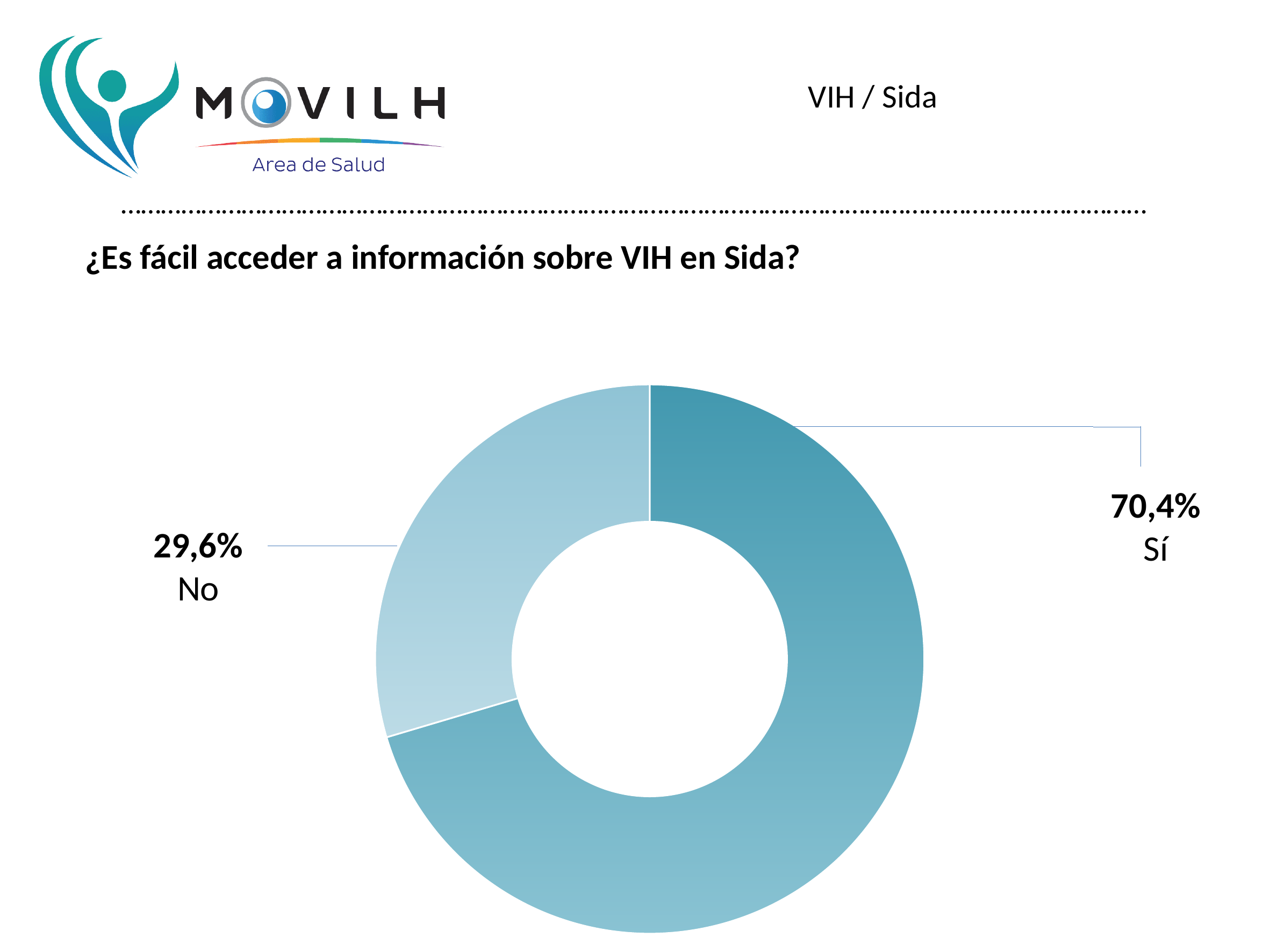
Which response has the smallest share of the chart? No How many categories are shown in the chart? 2 What percentage of respondents answered "Sí"? 70,4% What question does the chart answer, according to the slide title? ¿Es fácil acceder a información sobre VIH en Sida? What percentage of respondents answered "No"? 29,6% What kind of chart is shown on the slide? Doughnut (pie) chart What share of the chart does the "No" slice represent? 29,6% What is the difference in percentage points between the "Sí" and "No" shares? 40,8 Which is larger, the share for "Sí" or the share for "No"? Sí Which response has the largest share of the chart? Sí Which slice is drawn in the darker blue colour? Sí